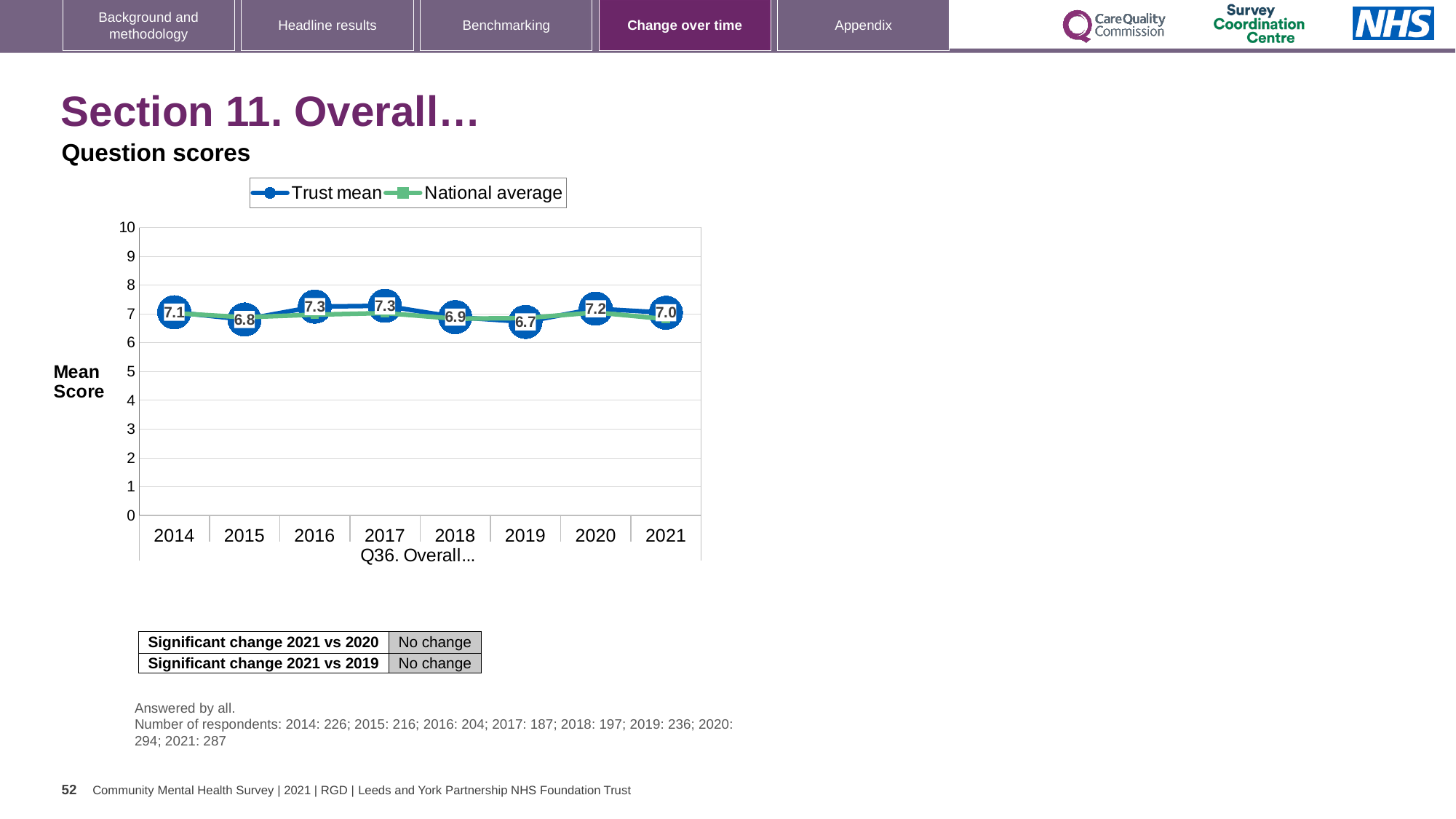
What is the Trust mean score for 2021? 7.0 What is the Trust mean score for 2015? 6.8 What is the Trust mean score for 2016? 7.3 What is the Trust mean score for 2019? 6.7 Which is larger, the Trust mean score for 2020 or for 2021? 2020 Is the National average value for 2014 greater or less than 5? greater Does the Trust mean score rise or fall from 2017 to 2019? fall What kind of chart is shown on the slide? line chart How many series does the legend list? 2 Which year has the lowest Trust mean score? 2019 How many years are shown on the x axis? 8 What is the difference between the Trust mean scores for 2017 and 2019? 0.6